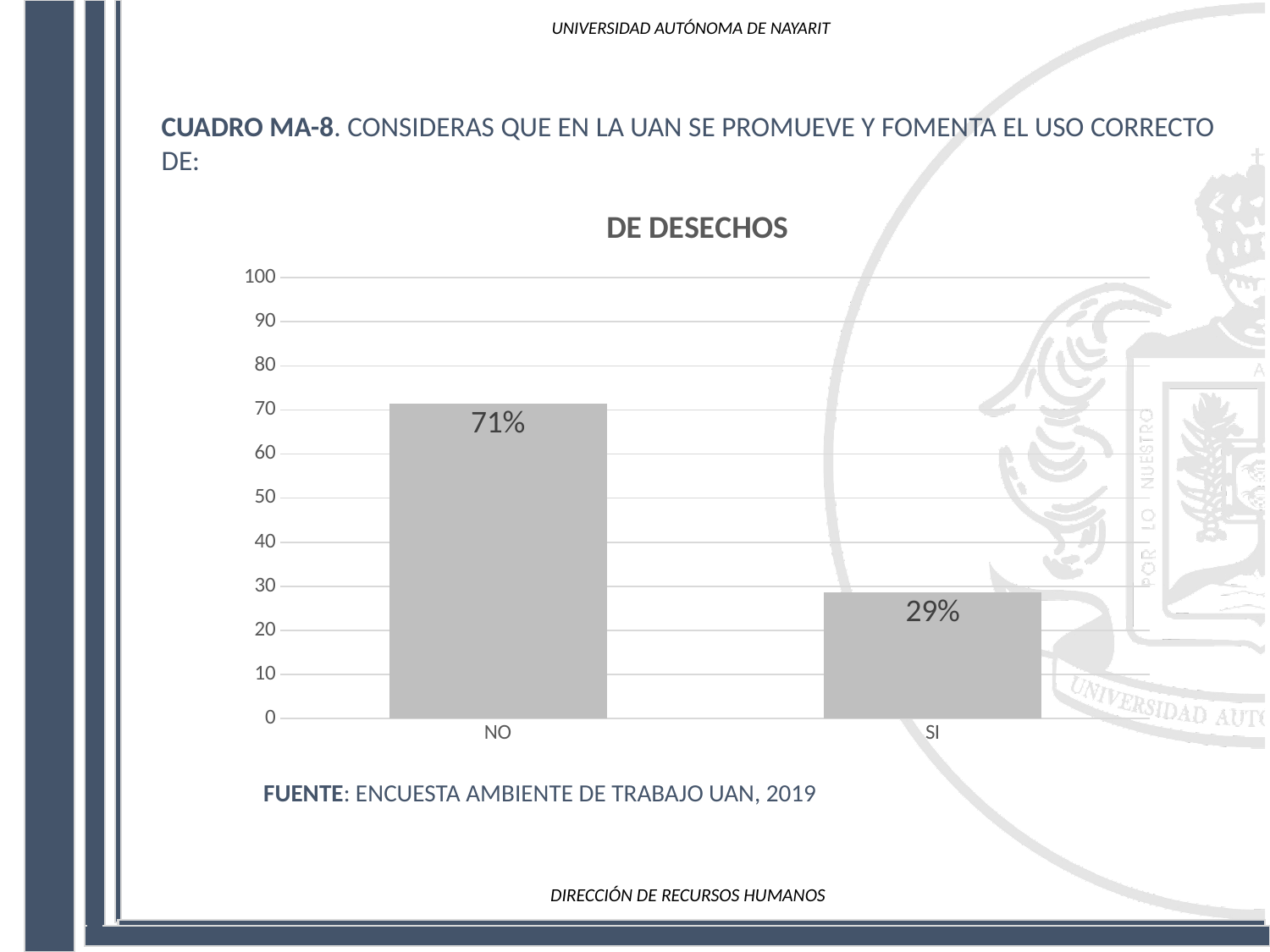
Which is larger, the value for NO or the value for SI? NO What is the value for NO? 71% What is the value for SI? 29% Which category has the lowest value? SI How many categories are shown on the x axis? 2 What kind of chart is shown? bar chart What is the title of the chart? DE DESECHOS Is the value for NO greater or less than 60? greater Is the value for SI greater or less than 40? less Which category has the highest value? NO What is the difference between the values for NO and SI? 42% What is the highest value shown on the vertical axis? 100